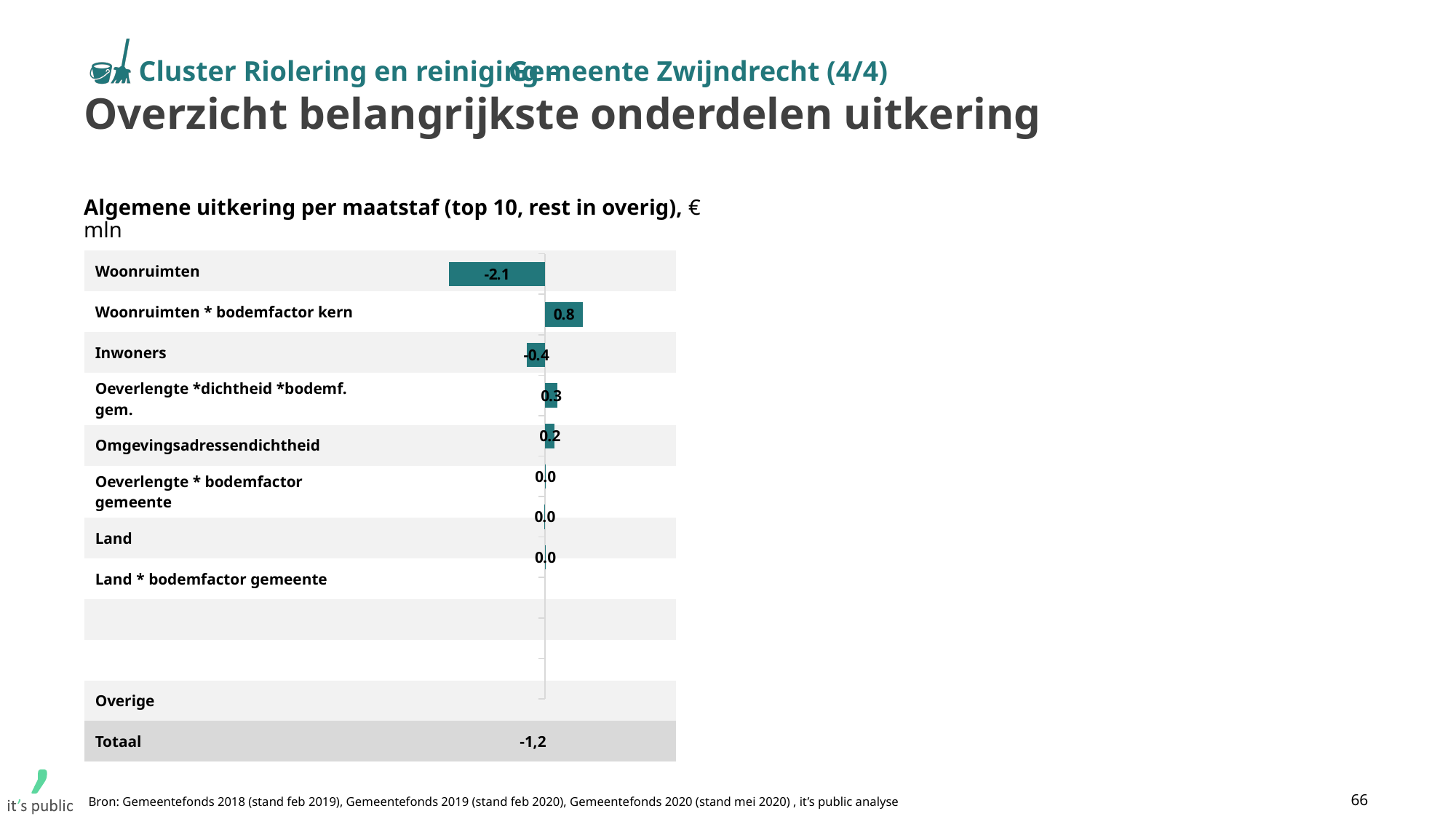
Which category has the highest (most positive) value? Woonruimten * bodemfactor kern What is the title of the chart? Algemene uitkering per maatstaf (top 10, rest in overig), € mln Which category has the lowest (most negative) value? Woonruimten What is the value for Woonruimten * bodemfactor kern? 0.8 What kind of chart is shown on the slide? Bar chart What is the value shown for Totaal? -1,2 What is the difference between the values for Woonruimten * bodemfactor kern and Inwoners? 1.2 Which is larger, the value for Oeverlengte *dichtheid *bodemf. gem. or the value for Omgevingsadressendichtheid? Oeverlengte *dichtheid *bodemf. gem. What is the value for Omgevingsadressendichtheid? 0.2 What is the value for Land? 0.0 What is the value for Inwoners? -0.4 What is the value for Woonruimten? -2.1